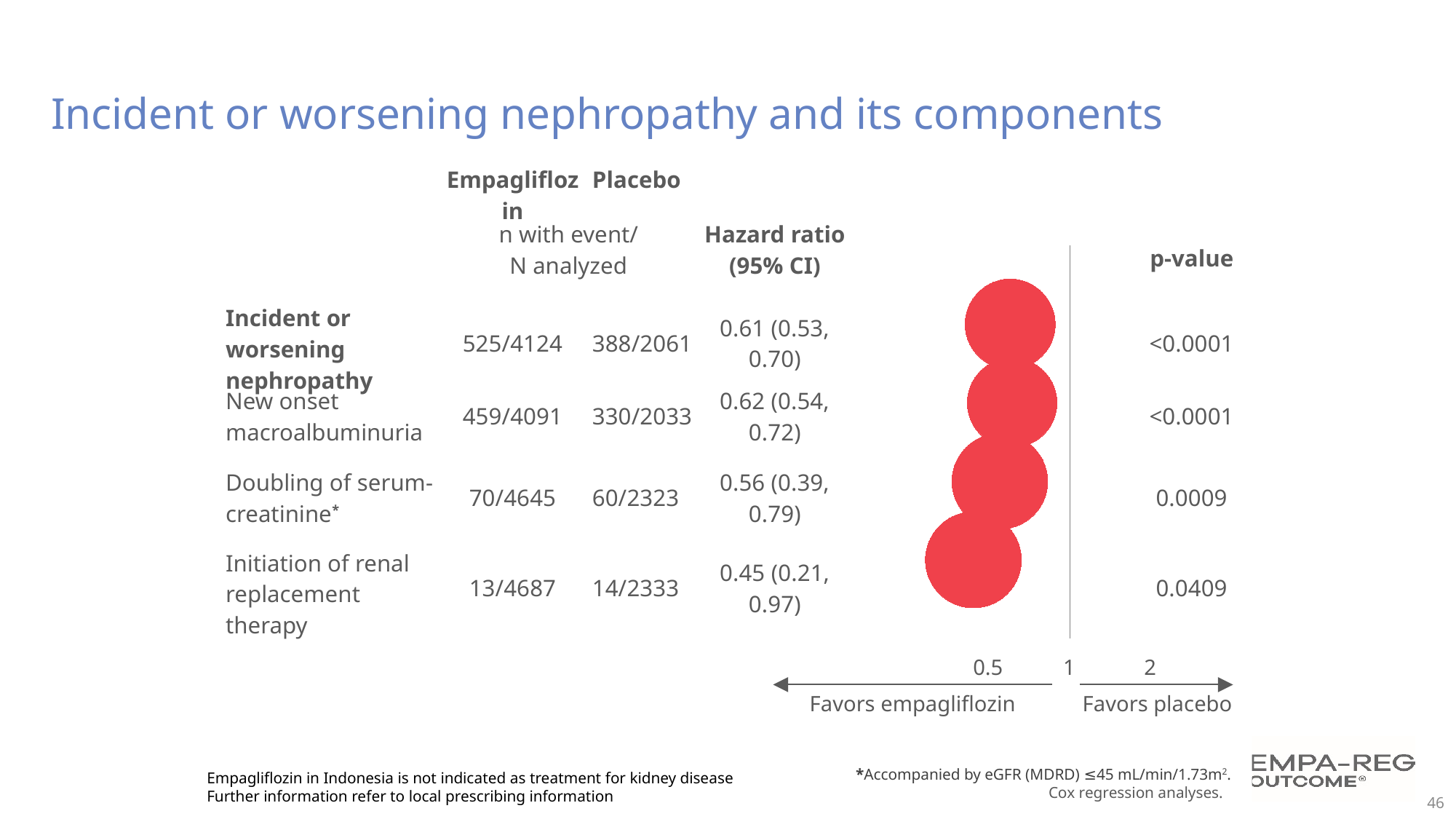
What is the p-value for doubling of serum-creatinine? 0.0009 Is the hazard ratio for doubling of serum-creatinine greater or less than 1? less What is the 95% CI for the hazard ratio of new onset macroalbuminuria? 0.54, 0.72 Which has the larger hazard ratio: doubling of serum-creatinine or initiation of renal replacement therapy? Doubling of serum-creatinine What is the difference between the hazard ratio for new onset macroalbuminuria and the hazard ratio for initiation of renal replacement therapy? 0.17 What kind of chart is shown on the slide? Forest plot What is the p-value for initiation of renal replacement therapy? 0.0409 What is the hazard ratio for incident or worsening nephropathy? 0.61 Which outcome has the lowest hazard ratio? Initiation of renal replacement therapy How many patients with an event out of N analyzed are reported for initiation of renal replacement therapy in the placebo group? 14/2333 What does the left side of the hazard ratio axis favor? Favors empagliflozin How many outcomes are plotted in the forest plot? 4